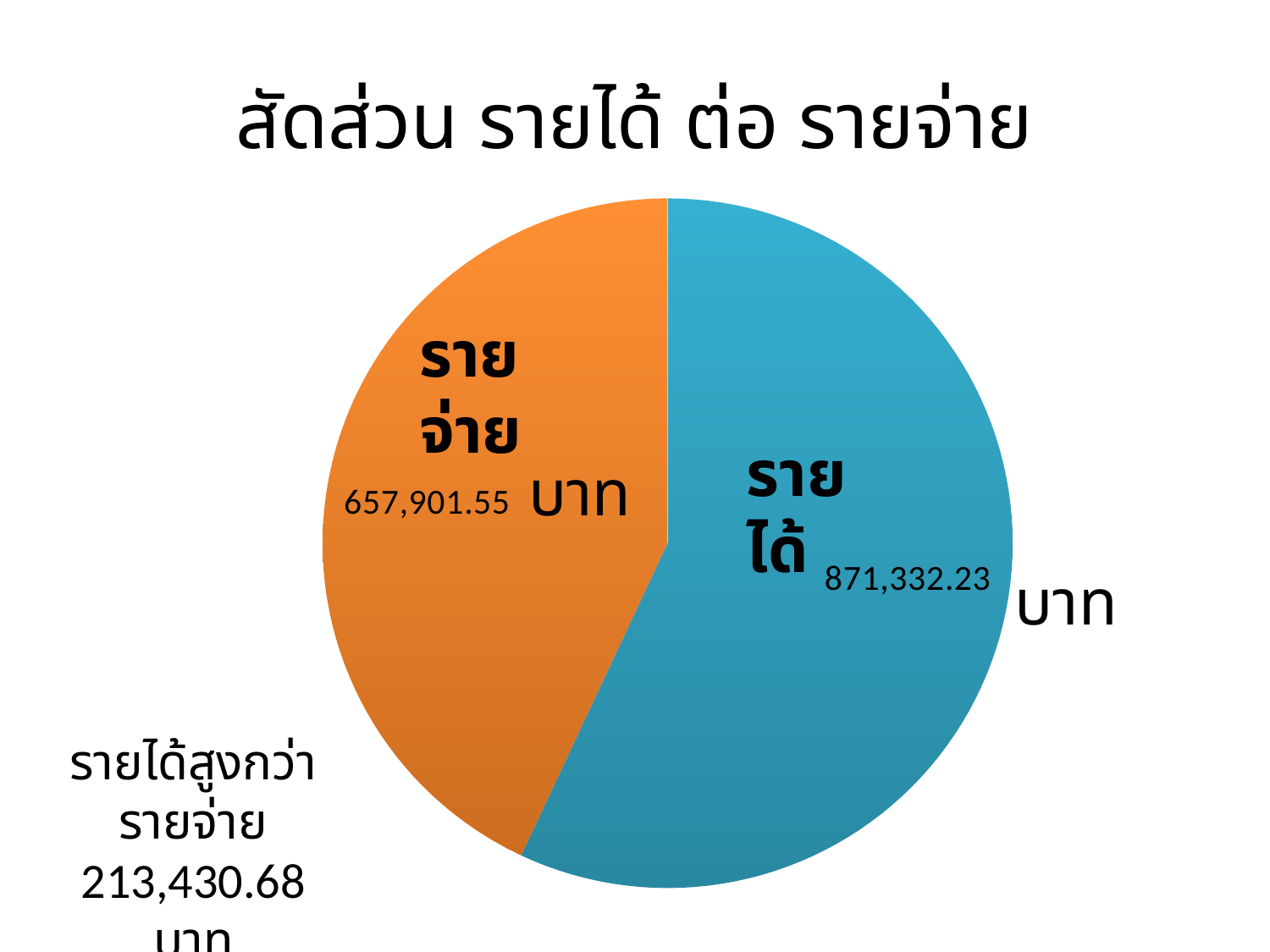
How many slices does the pie chart have? 2 What is the title of the chart? สัดส่วน รายได้ ต่อ รายจ่าย Which slice is larger, รายได้ or รายจ่าย? รายได้ Which category has the largest slice of the pie? รายได้ Which category has the smallest slice of the pie? รายจ่าย By how much does รายได้ exceed รายจ่าย? 213,430.68 บาท To the nearest whole percent, what share of the pie does รายได้ represent? 57% What is the combined total of รายได้ and รายจ่าย? 1,529,233.78 บาท What type of chart is shown on the slide? Pie chart What is the value shown for รายได้? 871,332.23 บาท What colour is the รายจ่าย slice? Orange What is the value shown for รายจ่าย? 657,901.55 บาท